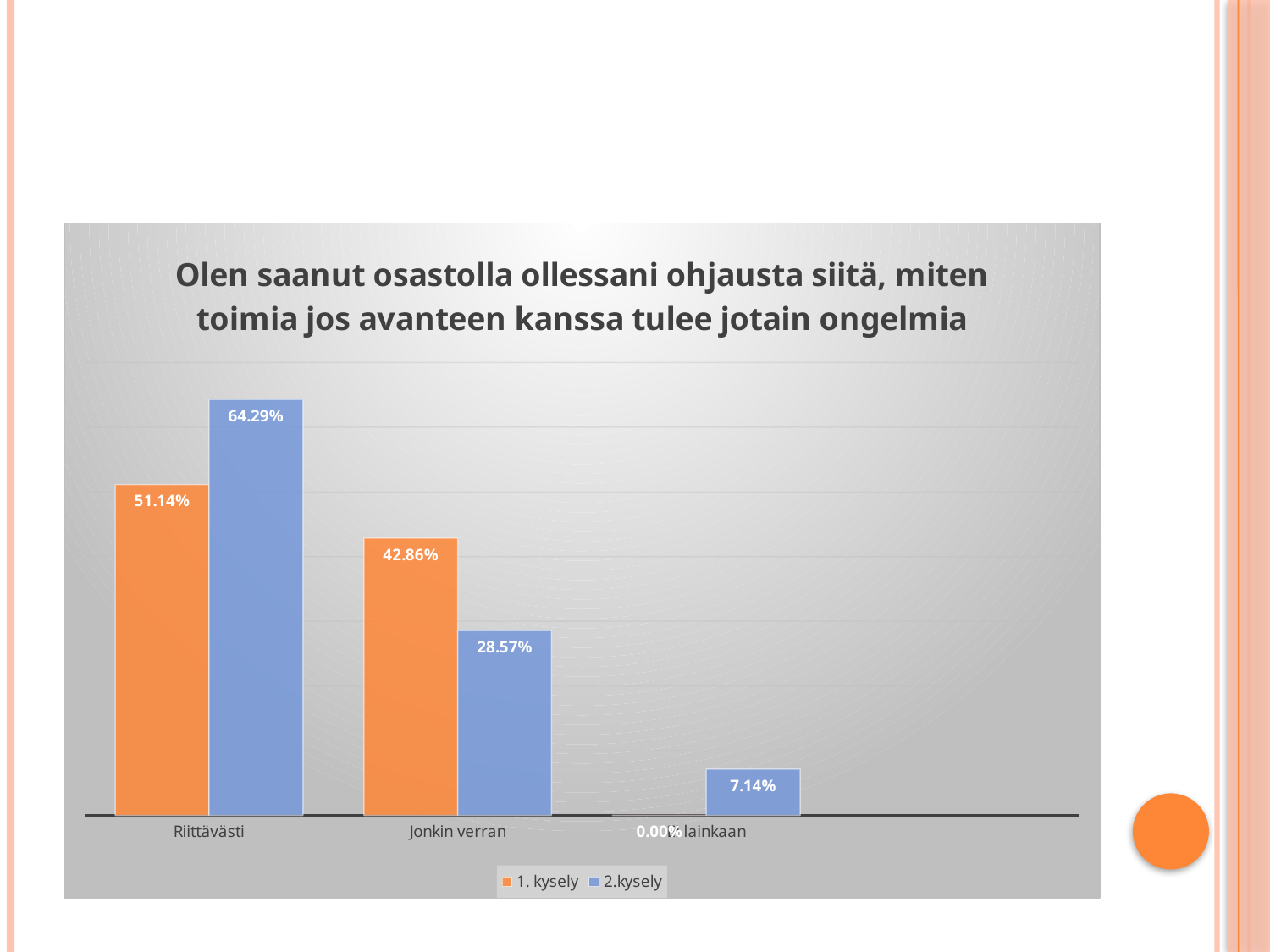
What is the value for Riittävästi in the 1. kysely series? 51.14% What kind of chart is shown on the slide? Bar chart What is the difference between the 2.kysely and 1. kysely values for Riittävästi? 13.15% What is the 2.kysely value for the third category (the one ending in 'lainkaan')? 7.14% How many series does the legend list? 2 What is the value for Jonkin verran in the 2.kysely series? 28.57% Which category has the lowest value in the 1. kysely series? The third category (ending in 'lainkaan'), 0.00% What is the value for Jonkin verran in the 1. kysely series? 42.86% How many categories are shown on the x axis? 3 Which category has the highest value in the 2.kysely series? Riittävästi What is the value for Riittävästi in the 2.kysely series? 64.29% For Jonkin verran, which series has the larger value, 1. kysely or 2.kysely? 1. kysely